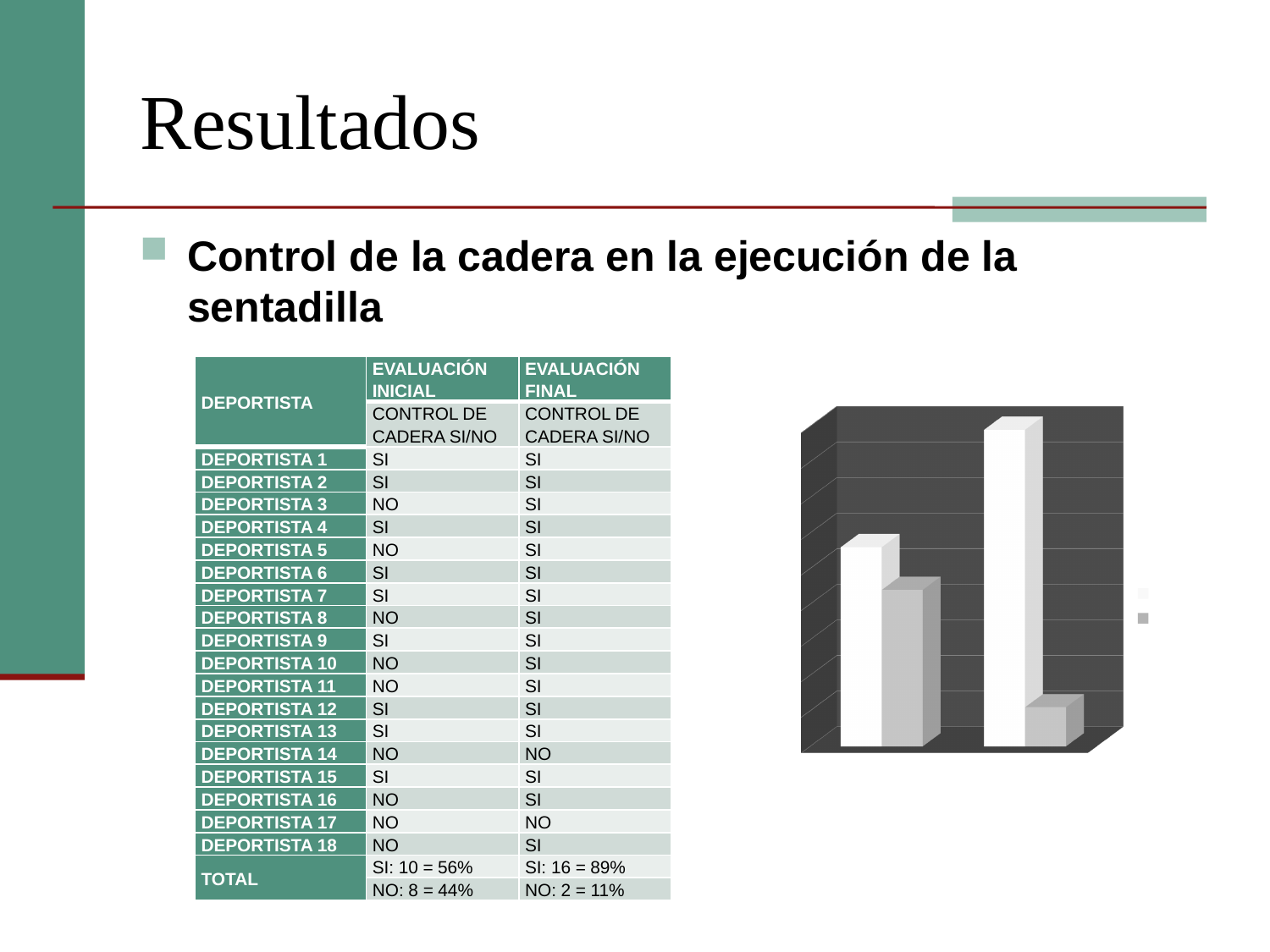
In the chart on the right of the slide, which bar is the tallest: the white bar in the left group, the grey bar in the left group, the white bar in the right group, or the grey bar in the right group? the white bar in the right group What kind of chart is shown on the right of the slide? bar chart In the chart on the right of the slide, does the white series rise or fall from the left group to the right group? rise What two colours are used for the bars in the chart on the right of the slide? white and grey How many bars are plotted in the chart on the right of the slide? 4 Does the chart on the right of the slide have a 3D style? yes In the chart on the right of the slide, is the white bar or the grey bar taller in the right group? the white bar In the chart on the right of the slide, which bar is the shortest: the white bar in the left group, the grey bar in the left group, the white bar in the right group, or the grey bar in the right group? the grey bar in the right group How many groups of bars does the chart on the right of the slide show? 2 In the chart on the right of the slide, is the white bar or the grey bar taller in the left group? the white bar In the chart on the right of the slide, does the grey series rise or fall from the left group to the right group? fall How many series does the legend of the chart on the right of the slide list? 2